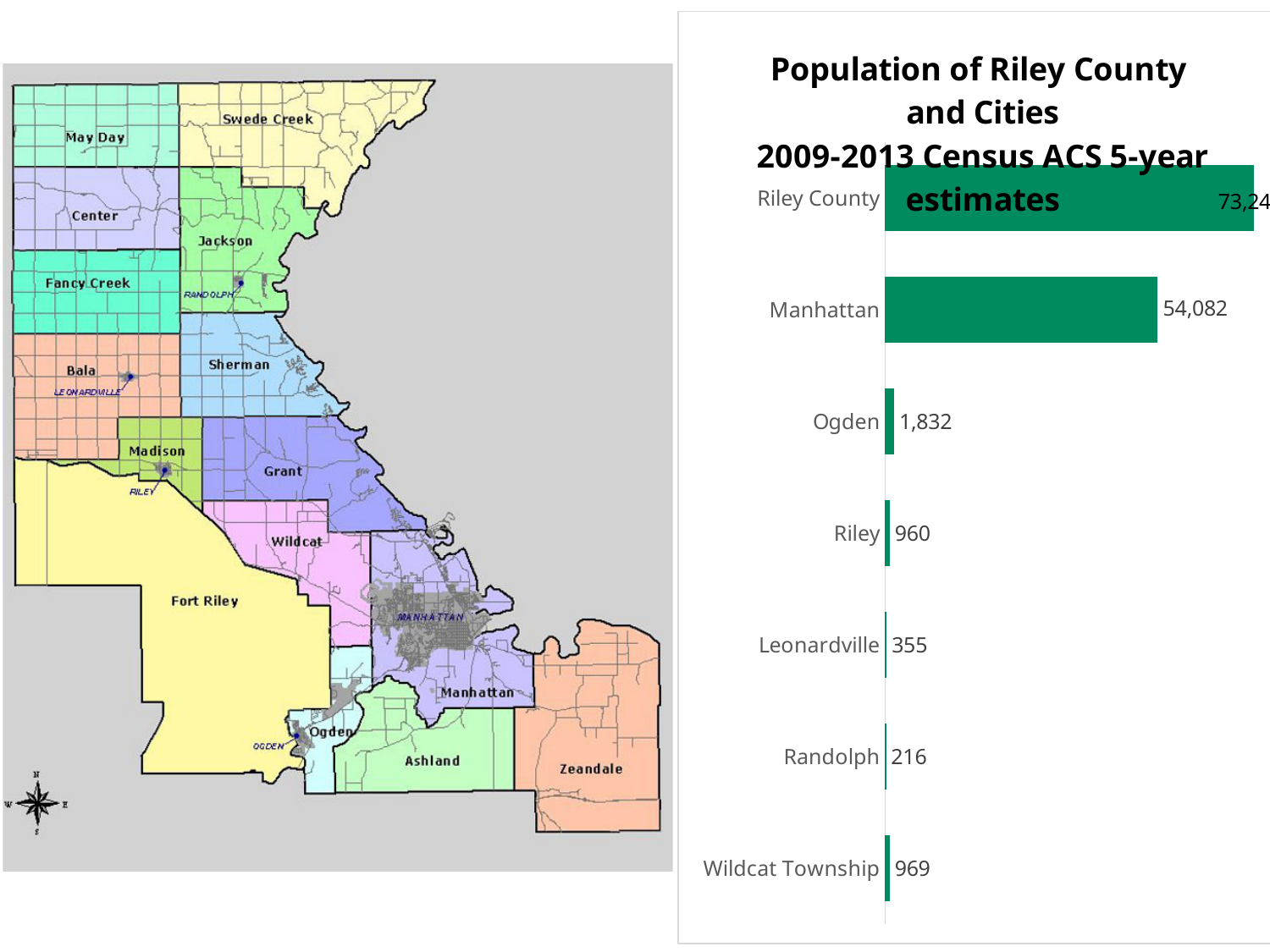
Which category has the highest population in the chart? Riley County What is the population shown for Leonardville? 355 What kind of chart is shown on the slide? Bar chart What is the difference in population between Manhattan and Ogden? 52,250 Which has a larger population, Ogden or Riley? Ogden What is the population shown for Wildcat Township? 969 How many categories are shown in the chart? 7 What is the population shown for Manhattan? 54,082 What is the difference in population between Leonardville and Randolph? 139 What is the population shown for Ogden? 1,832 What is the population shown for Randolph? 216 Which category has the lowest population in the chart? Randolph